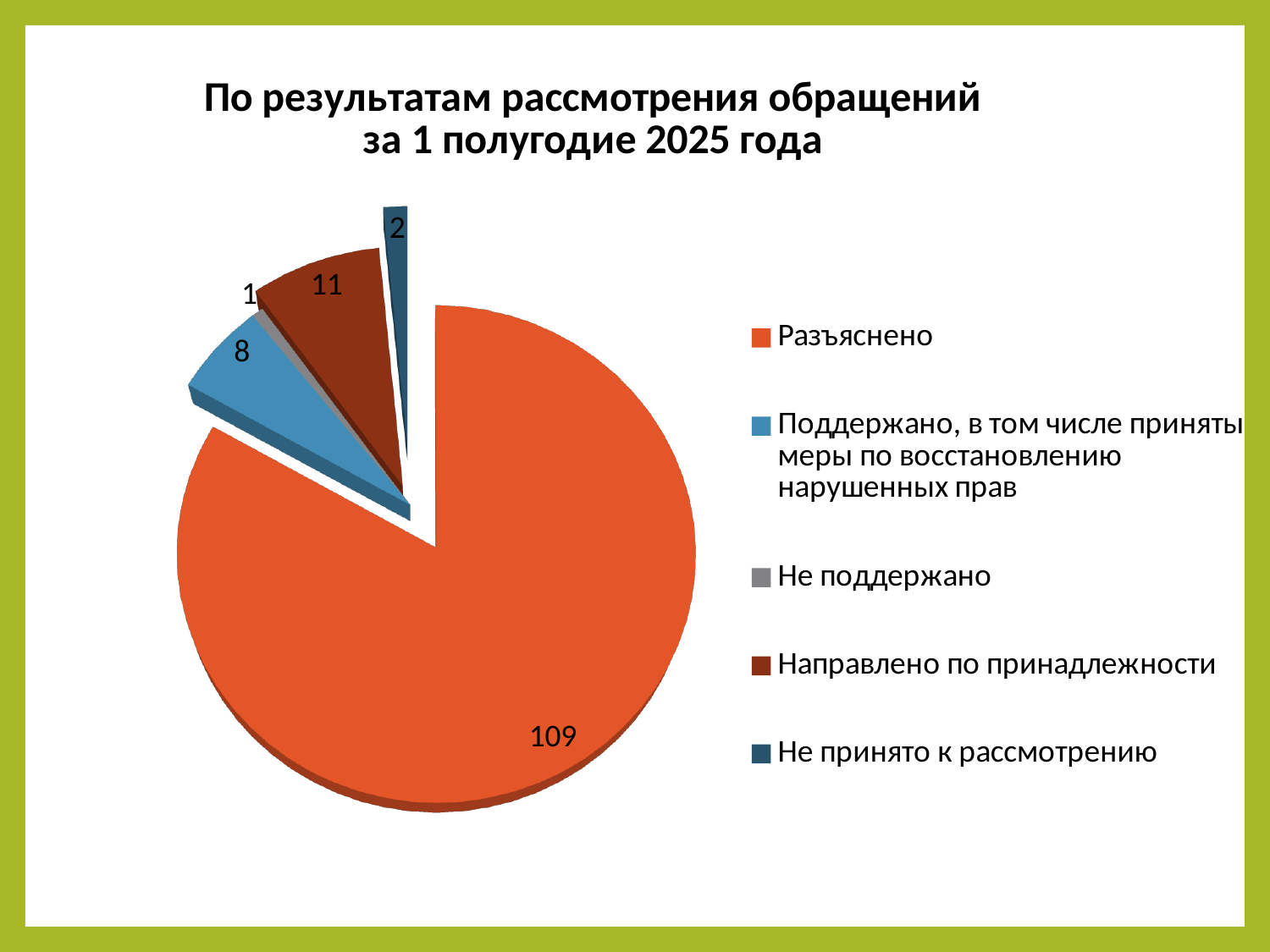
What is the value for "Поддержано, в том числе приняты меры по восстановлению нарушенных прав"? 8 What type of chart is shown on the slide? Pie chart What is the difference between the values for "Разъяснено" and "Направлено по принадлежности"? 98 Which category has the smallest slice? Не поддержано What is the value for "Направлено по принадлежности"? 11 What is the title of the chart? По результатам рассмотрения обращений за 1 полугодие 2025 года How many categories does the legend list? 5 What is the value for "Не принято к рассмотрению"? 2 What is the value for "Разъяснено"? 109 What is the value for "Не поддержано"? 1 Which is larger: "Направлено по принадлежности" or "Поддержано, в том числе приняты меры по восстановлению нарушенных прав"? Направлено по принадлежности Which category has the largest slice? Разъяснено